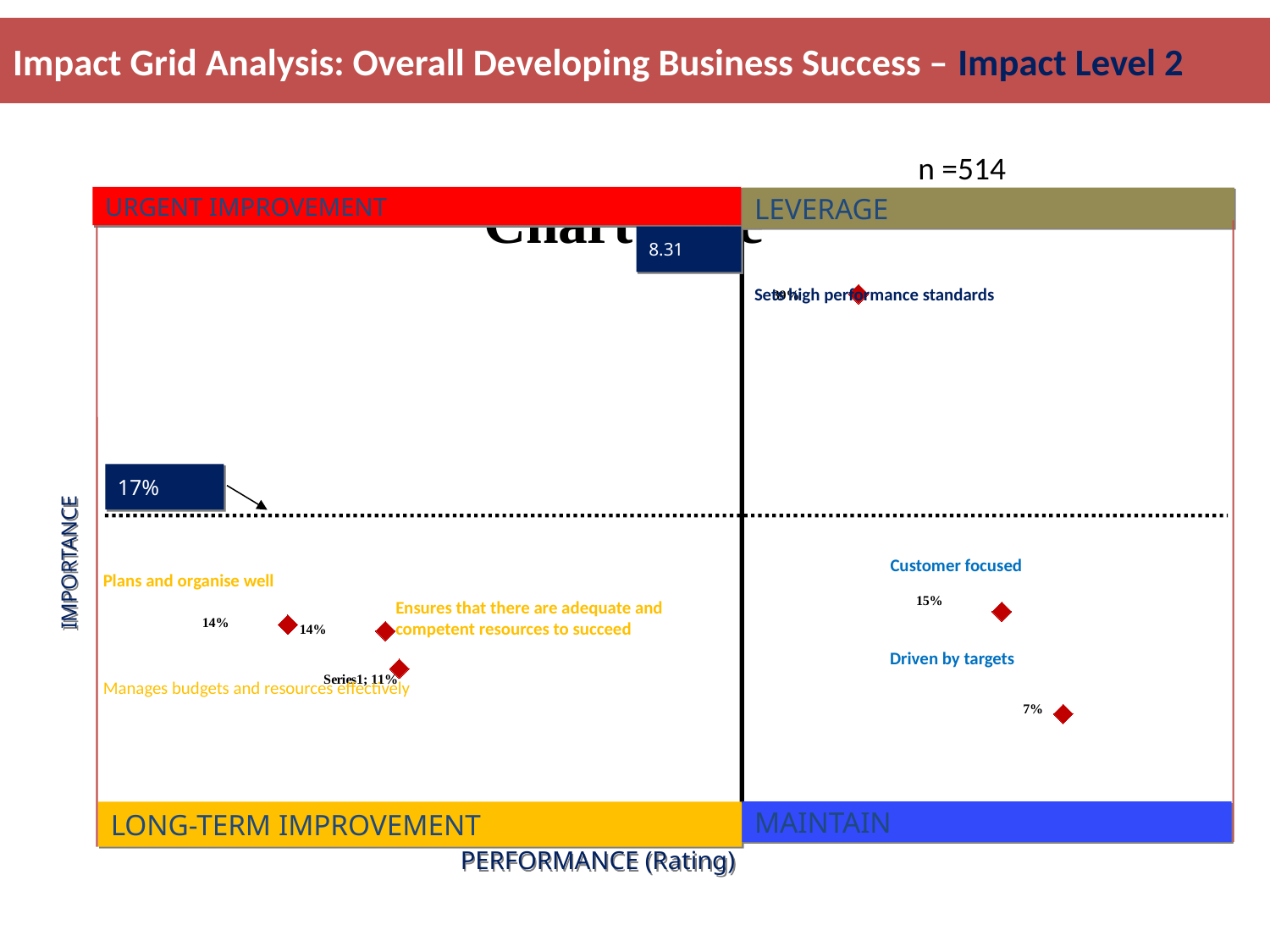
What is the value shown for Ensures that there are adequate and competent resources to succeed? 14% What is the value shown for Manages budgets and resources effectively? 11% Which has the larger value, Customer focused or Driven by targets? Customer focused How many data points are plotted on the chart? 6 What is the value shown for Plans and organise well? 14% What is the difference between the values for Customer focused and Driven by targets? 8% What kind of chart is shown on the slide? Scatter chart What is the value shown for Customer focused? 15% What is the label of the horizontal axis of the chart? PERFORMANCE (Rating) Which labelled point has the lowest value on the chart? Driven by targets Is the importance value for Driven by targets greater or less than 17%? less What is the value shown for Driven by targets? 7%